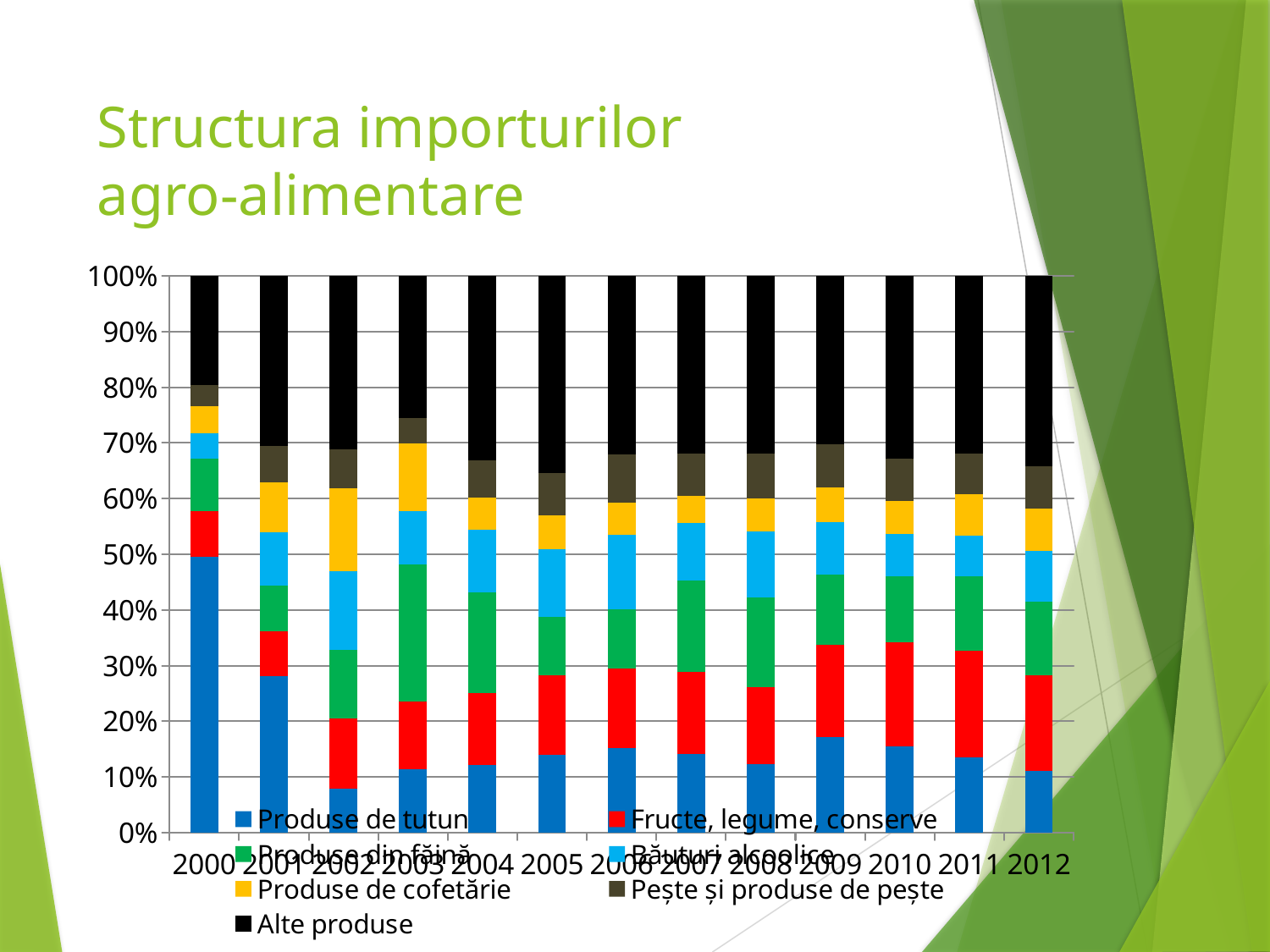
What is the title of the slide containing the chart? Structura importurilor agro-alimentare Which year has a larger share of 'Produse de tutun', 2000 or 2001? 2000 How many series does the chart legend list? 7 Which colour represents 'Alte produse' in the chart? Black Is the share of 'Produse de tutun' in 2000 greater or less than 40%? greater What is the total height of each stacked bar in the chart? 100% Is the share of 'Produse de tutun' in 2001 greater or less than 20%? greater Does the share of 'Produse de tutun' rise or fall from 2000 to 2002? fall In which year is the share of 'Alte produse' the smallest? 2000 In which year is the share of 'Produse de tutun' the highest? 2000 How many years are shown on the x axis of the chart? 13 What type of chart is shown on the slide? Stacked bar chart